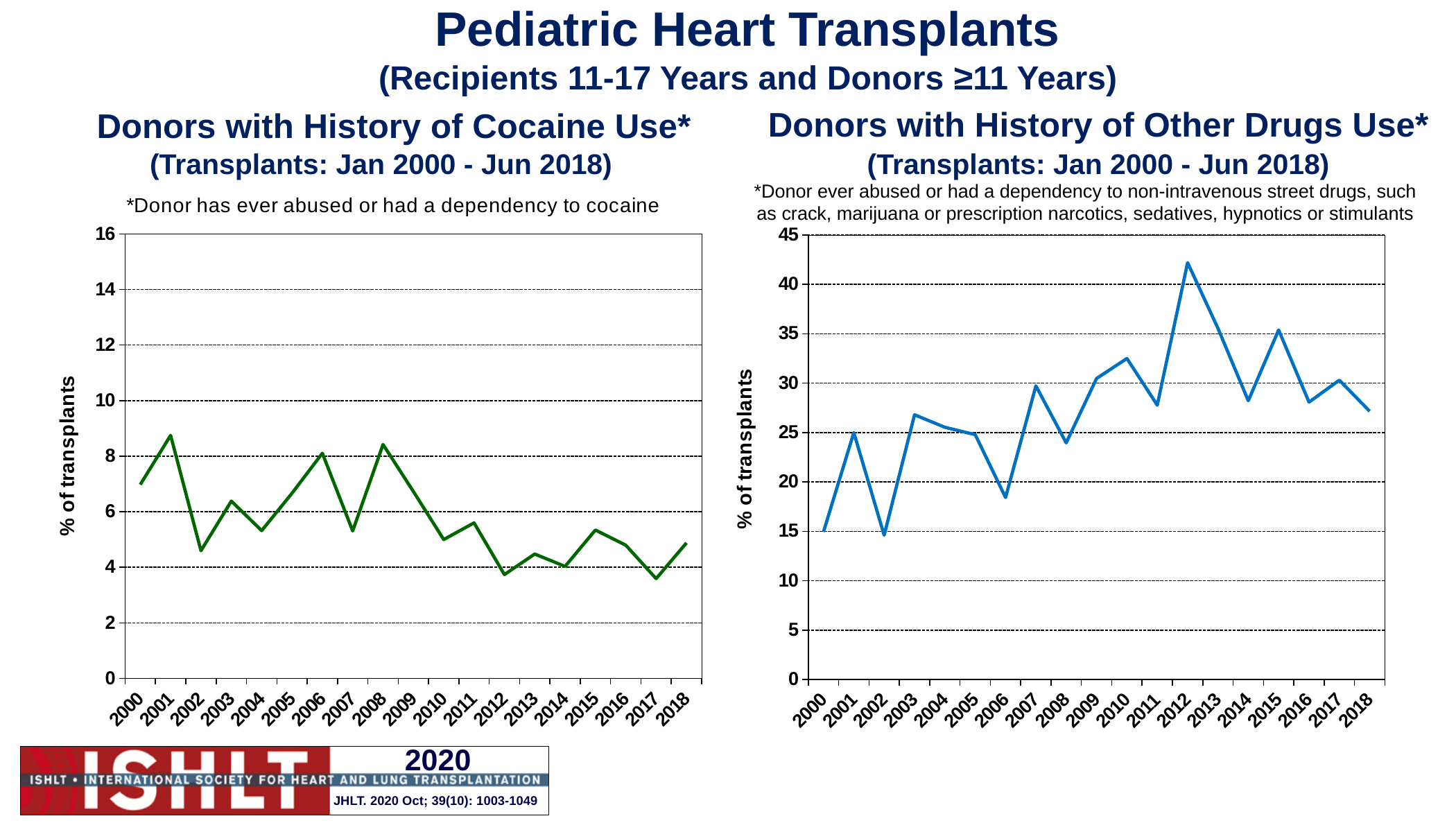
In the 'Donors with History of Cocaine Use' chart on the left, is the value for 2001 greater or less than 8? greater In the 'Donors with History of Other Drugs Use' chart on the right, is the value for 2006 greater or less than 20? less In the 'Donors with History of Other Drugs Use' chart on the right, which year has the larger value, 2010 or 2011? 2010 In the 'Donors with History of Other Drugs Use' chart on the right, is the value for 2012 greater or less than 40? greater In the 'Donors with History of Other Drugs Use' chart on the right, which year has the highest value? 2012 In the 'Donors with History of Cocaine Use' chart on the left, which year has the larger value, 2002 or 2003? 2003 In the 'Donors with History of Other Drugs Use' chart on the right, which year has the larger value, 2012 or 2013? 2012 What colour is the line in the 'Donors with History of Other Drugs Use' chart on the right? blue What is the y-axis label of the 'Donors with History of Cocaine Use' chart on the left? % of transplants What kind of chart is the 'Donors with History of Cocaine Use' chart on the left? line chart How many years are plotted on the x axis of the 'Donors with History of Other Drugs Use' chart on the right? 19